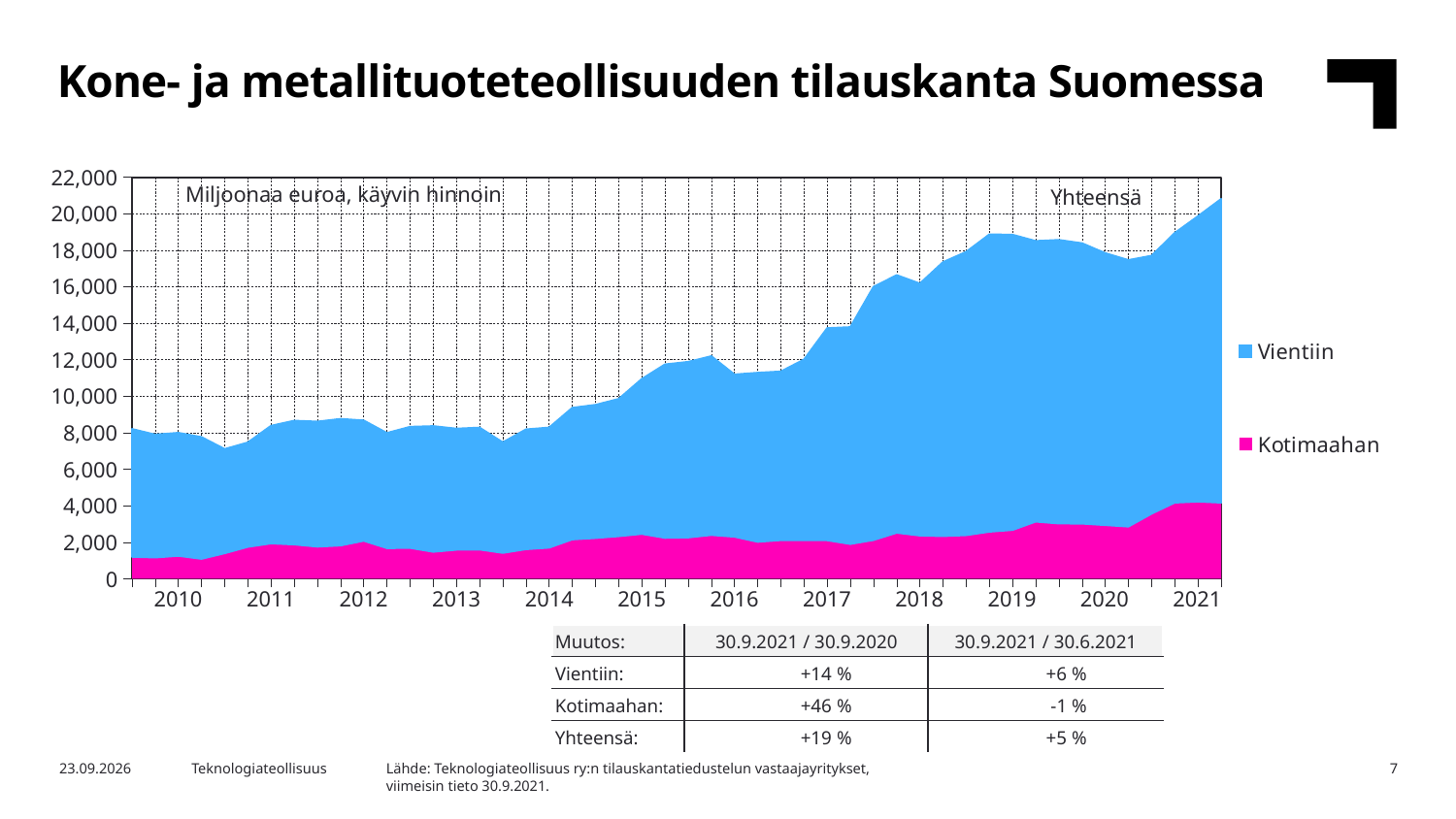
In which year does the total order backlog reach its highest level? 2021 Is the total order backlog at the end of 2021 greater or less than 20,000? greater What unit is stated on the chart for the plotted values? Miljoonaa euroa, käyvin hinnoin Which series is larger throughout the chart, Vientiin or Kotimaahan? Vientiin What is the title of the chart on the slide? Kone- ja metallituoteteollisuuden tilauskanta Suomessa Is the total order backlog at the start of 2010 greater or less than 10,000? less How many series does the chart legend list? 2 Does the total order backlog (Yhteensä) rise or fall overall from 2010 to 2021? Rise Is the Kotimaahan value at the end of 2021 greater or less than 2,000? greater How many years are labelled on the x axis of the chart? 12 What kind of chart is shown on the slide? Area chart